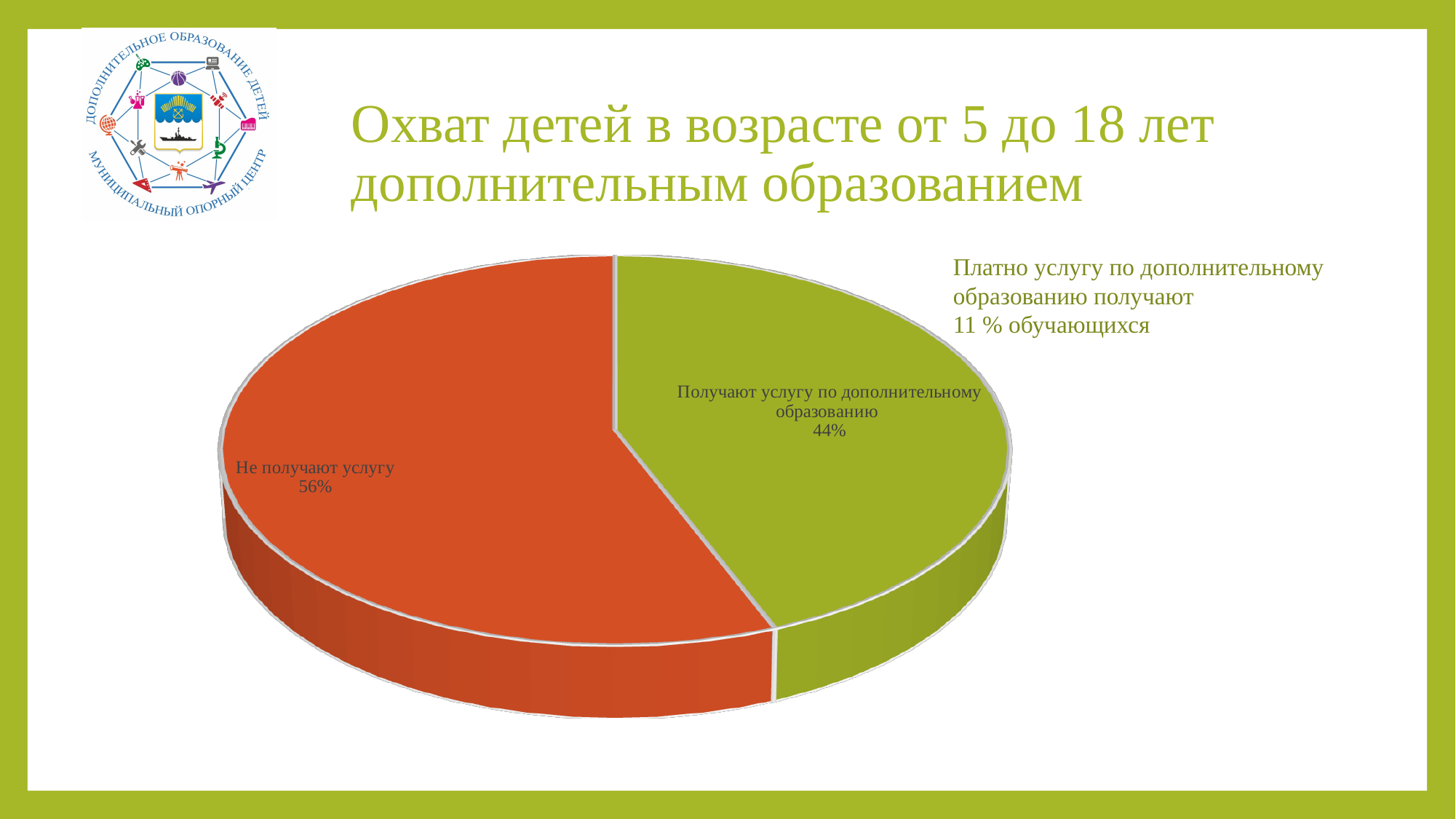
What share of the pie is labelled "Не получают услугу"? 56% How many slices does the pie chart have? 2 Which is larger: the share of children who receive the service ("Получают услугу по дополнительному образованию") or the share who do not ("Не получают услугу")? Не получают услугу Which slice of the pie is the largest? Не получают услугу What kind of chart is shown on the slide? Pie chart What colour is the "Получают услугу по дополнительному образованию" slice? Green What colour is the "Не получают услугу" slice? Orange What is the difference in percentage points between the "Не получают услугу" slice and the "Получают услугу по дополнительному образованию" slice? 12 Is the share for "Получают услугу по дополнительному образованию" greater or less than 50%? less Which slice of the pie is the smallest? Получают услугу по дополнительному образованию What share of the pie is labelled "Получают услугу по дополнительному образованию"? 44%